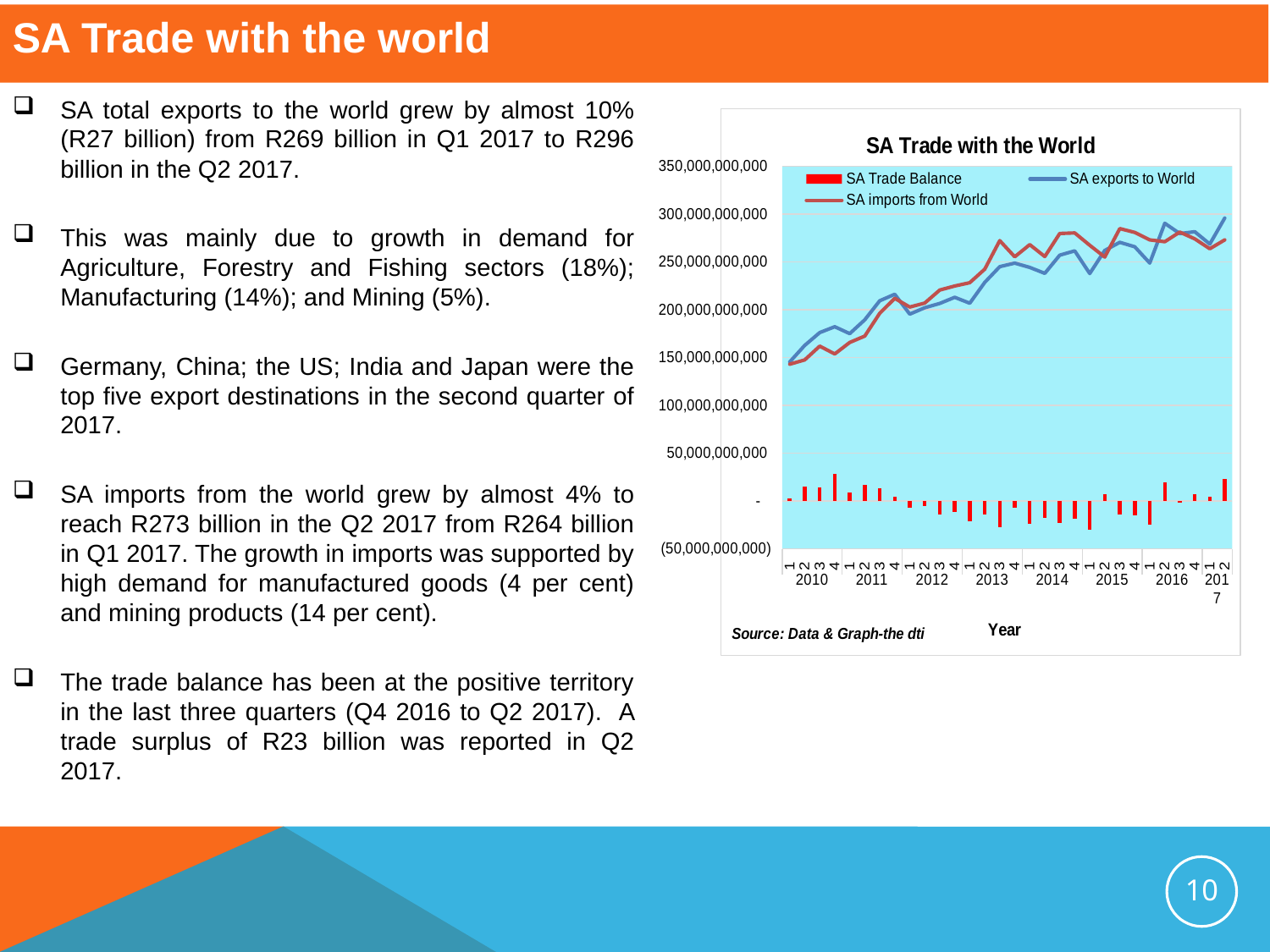
How many years are labelled on the x axis of the 'SA Trade with the World' chart? 8 In the 'SA Trade with the World' chart, which series has the highest value in Q2 2017? SA exports to World In the 'SA Trade with the World' chart, is the value of SA exports to World in Q2 2017 greater or less than 250,000,000,000? greater In the 'SA Trade with the World' chart, is the SA Trade Balance in Q2 2017 greater or less than 50,000,000,000? less In the 'SA Trade with the World' chart, which series has the lowest values throughout the period? SA Trade Balance How many series does the legend of the 'SA Trade with the World' chart list? 3 What is the x-axis label of the 'SA Trade with the World' chart? Year In the 'SA Trade with the World' chart, is the value of SA imports from World in Q1 2010 greater or less than 200,000,000,000? less What kind of chart is 'SA Trade with the World'? A combined bar and line chart Which series in the 'SA Trade with the World' chart is plotted as bars? SA Trade Balance In the 'SA Trade with the World' chart, which is larger in Q1 2013: SA exports to World or SA imports from World? SA imports from World In the 'SA Trade with the World' chart, do SA exports to World generally rise or fall from 2010 to 2017? Rise